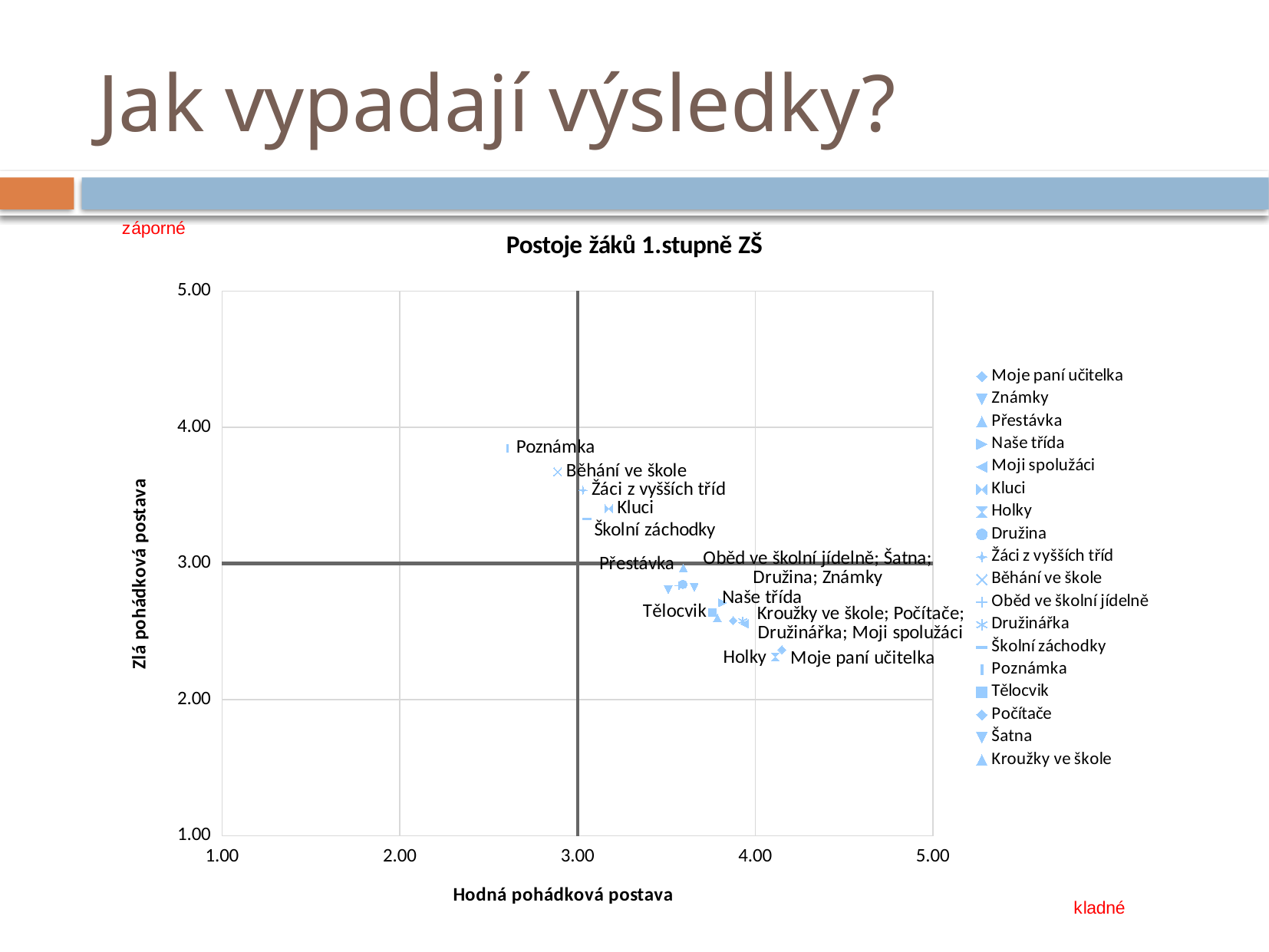
What is the title of the horizontal axis? Hodná pohádková postava What kind of chart is shown on the slide? scatter chart What is the title of the chart? Postoje žáků 1.stupně ZŠ How many series does the chart legend list? 18 Is the horizontal-axis value for Moje paní učitelka greater or less than 4.00? greater Is the horizontal-axis value for Kluci greater or less than 3.00? greater Is the horizontal-axis value for Poznámka greater or less than 3.00? less Which has the higher vertical-axis value, Poznámka or Kluci? Poznámka Which labelled point has the highest value on the vertical axis (Zlá pohádková postava)? Poznámka Which labelled point has the lowest value on the horizontal axis (Hodná pohádková postava)? Poznámka